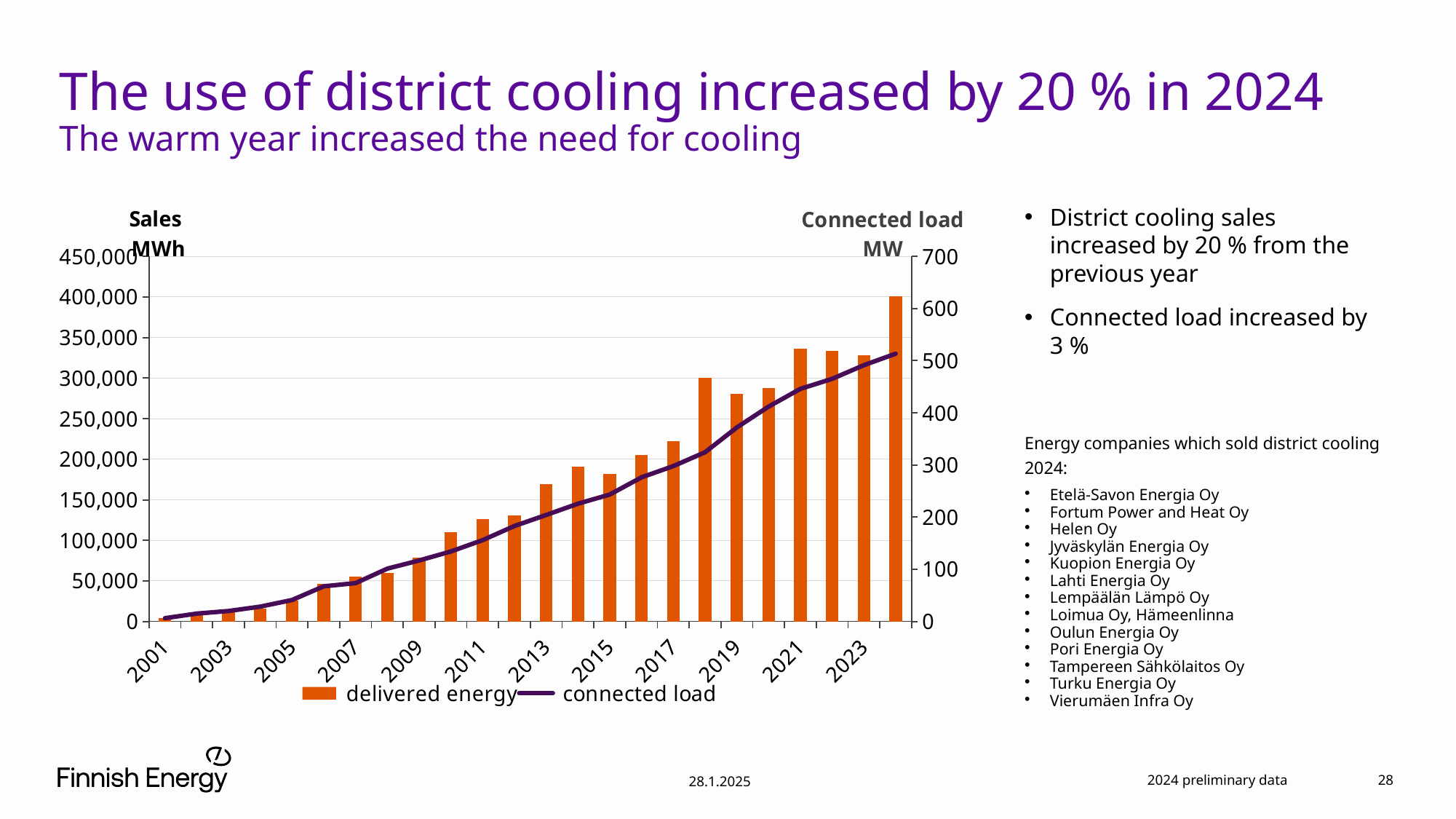
What are the two series named in the legend? delivered energy and connected load What kind of chart is shown on the slide? A bar chart combined with a line chart Do the delivered energy values generally rise or fall from 2001 to 2024? Rise How many series does the legend list? 2 Which year has the larger delivered energy bar, 2018 or 2019? 2018 Which year has the lowest delivered energy bar? 2001 Is the delivered energy for 2024 greater or less than 350,000 MWh? greater Is the delivered energy for 2005 greater or less than 50,000 MWh? less Is the connected load for 2024 greater or less than 500 MW? greater What is the title of the left vertical axis? Sales MWh Which year has the highest delivered energy bar? 2024